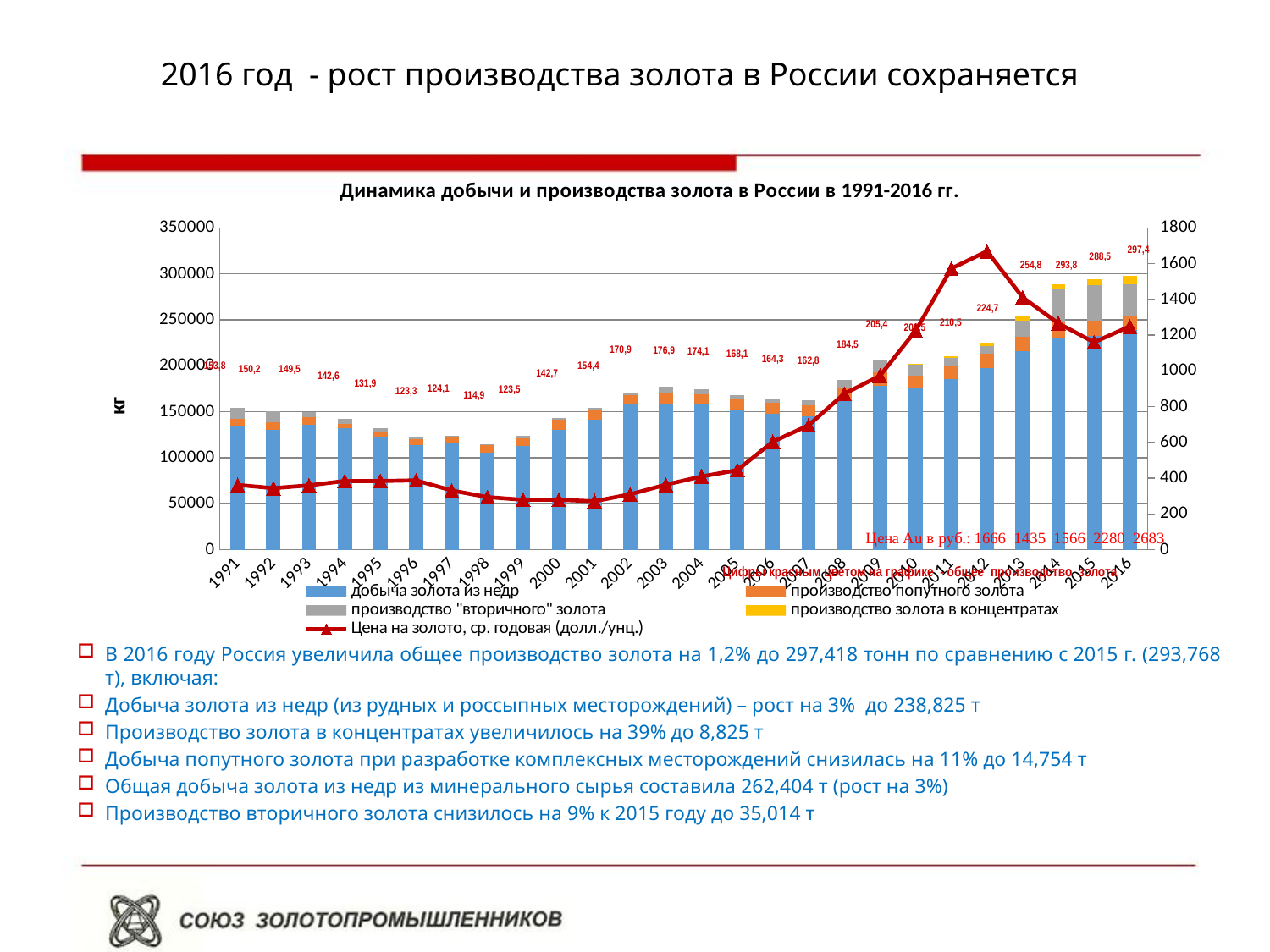
What total gold production (red label) is shown for 2012? 224,7 Which year has the larger red total production label, 2002 or 2007? 2002 What is the title of the chart? Динамика добычи и производства золота в России в 1991-2016 гг. How many years are shown on the x axis of the chart? 26 Is the average gold price (red line, right axis) for 2001 greater or less than 400? less What total gold production (red label) is shown for 1998? 114,9 What kind of chart is shown on the slide? Stacked bar chart with a line What is the difference between the red total production labels for 2016 and 2012? 72,7 How many series does the chart legend list? 5 Which year has the lowest total gold production according to the red labels? 1998 What total gold production (red label) is shown for 2016? 297,4 Does the total gold production (red labels) rise or fall from 2008 to 2016? rise